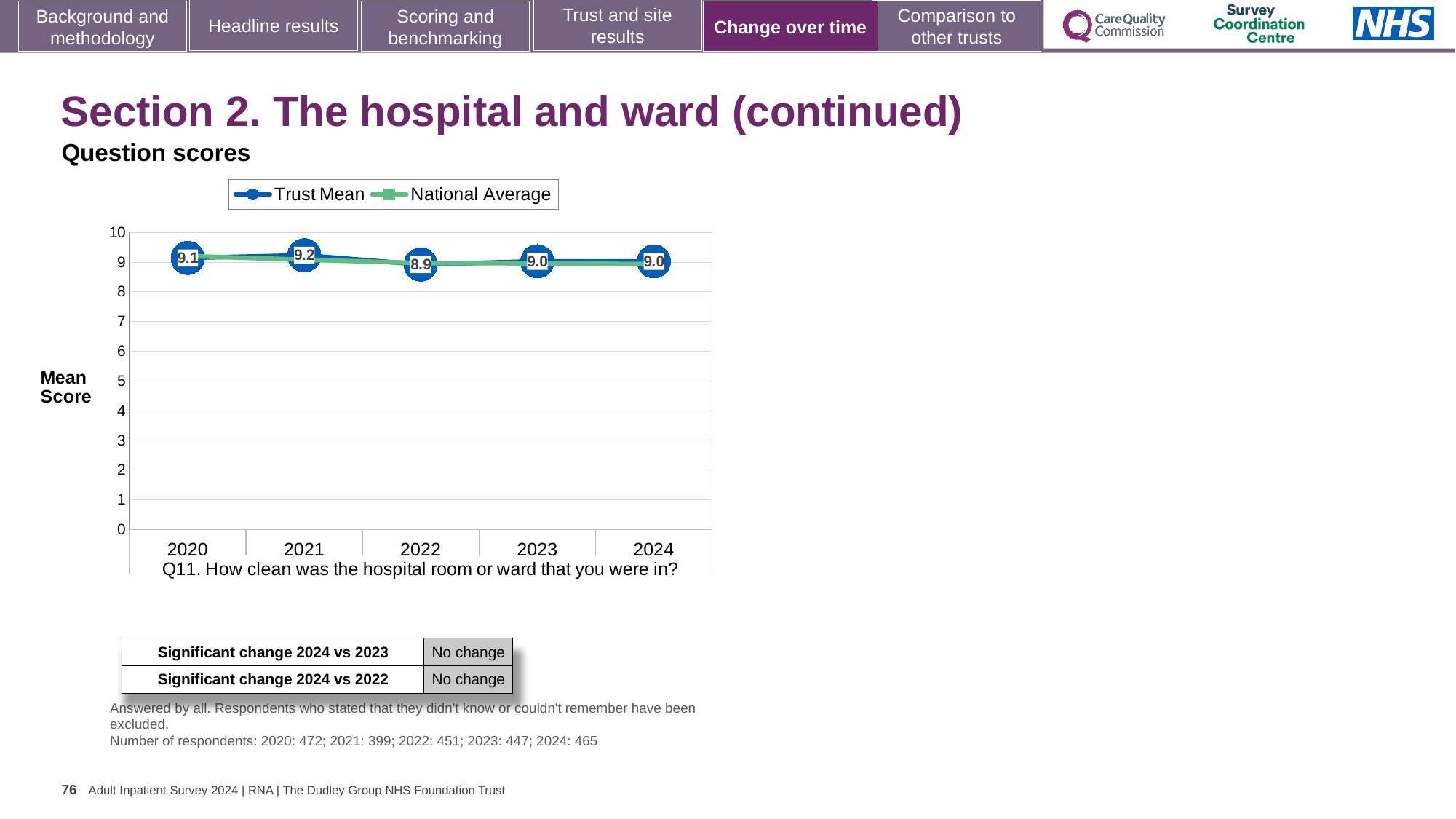
In which year is the Trust Mean score lowest? 2022 Is the National Average value for 2024 greater or less than 5? greater What is the Trust Mean score for 2024? 9.0 What is the Trust Mean score for 2022? 8.9 Does the Trust Mean score rise or fall from 2021 to 2022? Fall How many series does the chart legend list? 2 What kind of chart is shown on the slide? Line chart How many years are shown on the x axis of the chart? 5 In which year is the Trust Mean score highest? 2021 What is the Trust Mean score for 2021? 9.2 Which is larger, the Trust Mean score for 2020 or for 2022? 2020 What is the difference between the Trust Mean scores for 2021 and 2022? 0.3